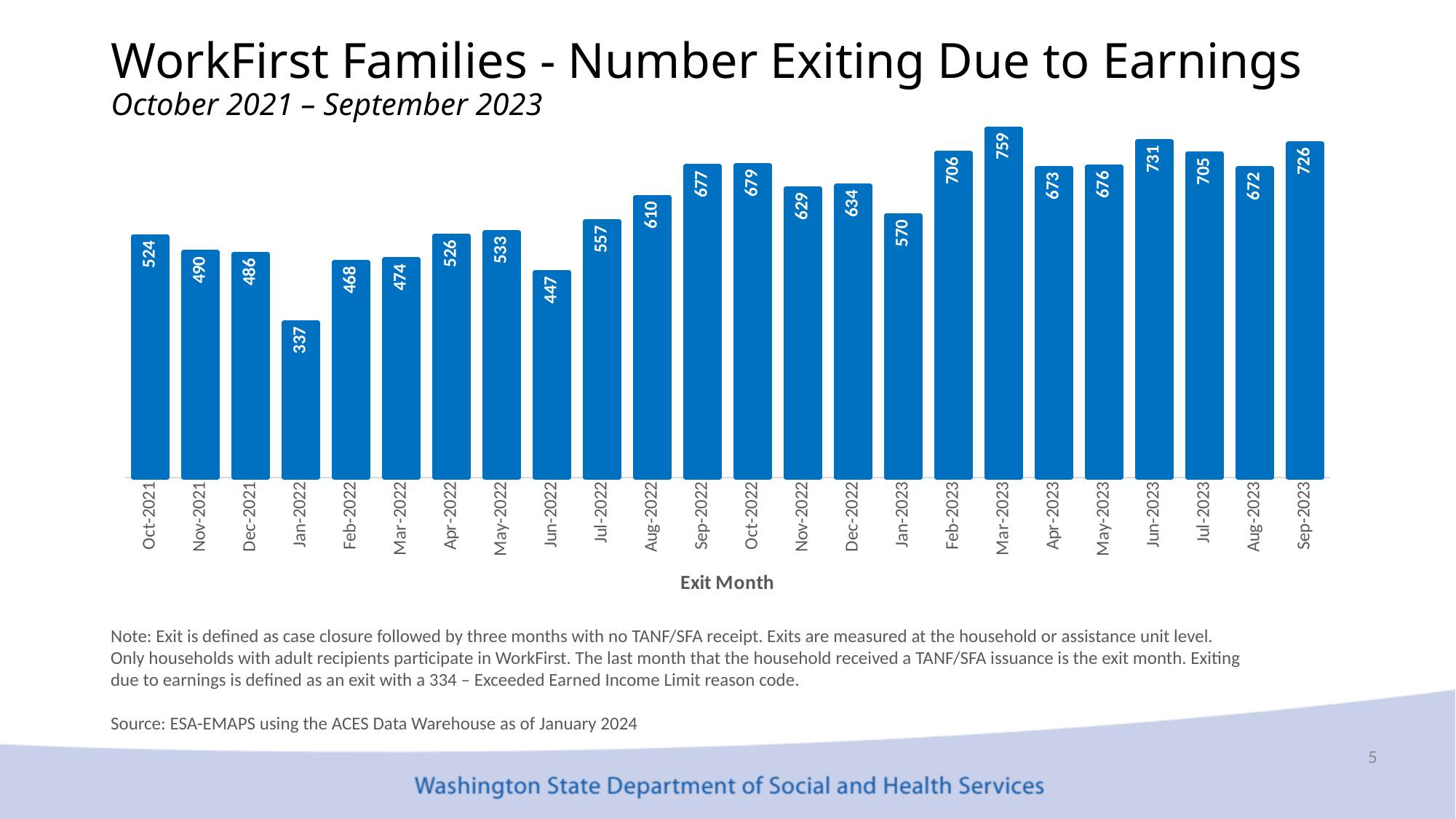
How many exit months are plotted on the chart? 24 What is the difference between the values for Mar-2023 and Jan-2022? 422 Which exit month has the highest number of families exiting due to earnings? Mar-2023 What is the value shown for Sep-2023? 726 Which is larger, the value for Jun-2023 or the value for Jul-2023? Jun-2023 What kind of chart is shown on the slide? Bar chart What is the value shown for Oct-2021? 524 Which exit month has the lowest number of families exiting due to earnings? Jan-2022 Do the values generally rise or fall from Jan-2022 to Mar-2023? Rise What is the difference between the values for Sep-2022 and Aug-2022? 67 What is the number of WorkFirst families exiting due to earnings in Jan-2022? 337 What is the x-axis title of the chart? Exit Month